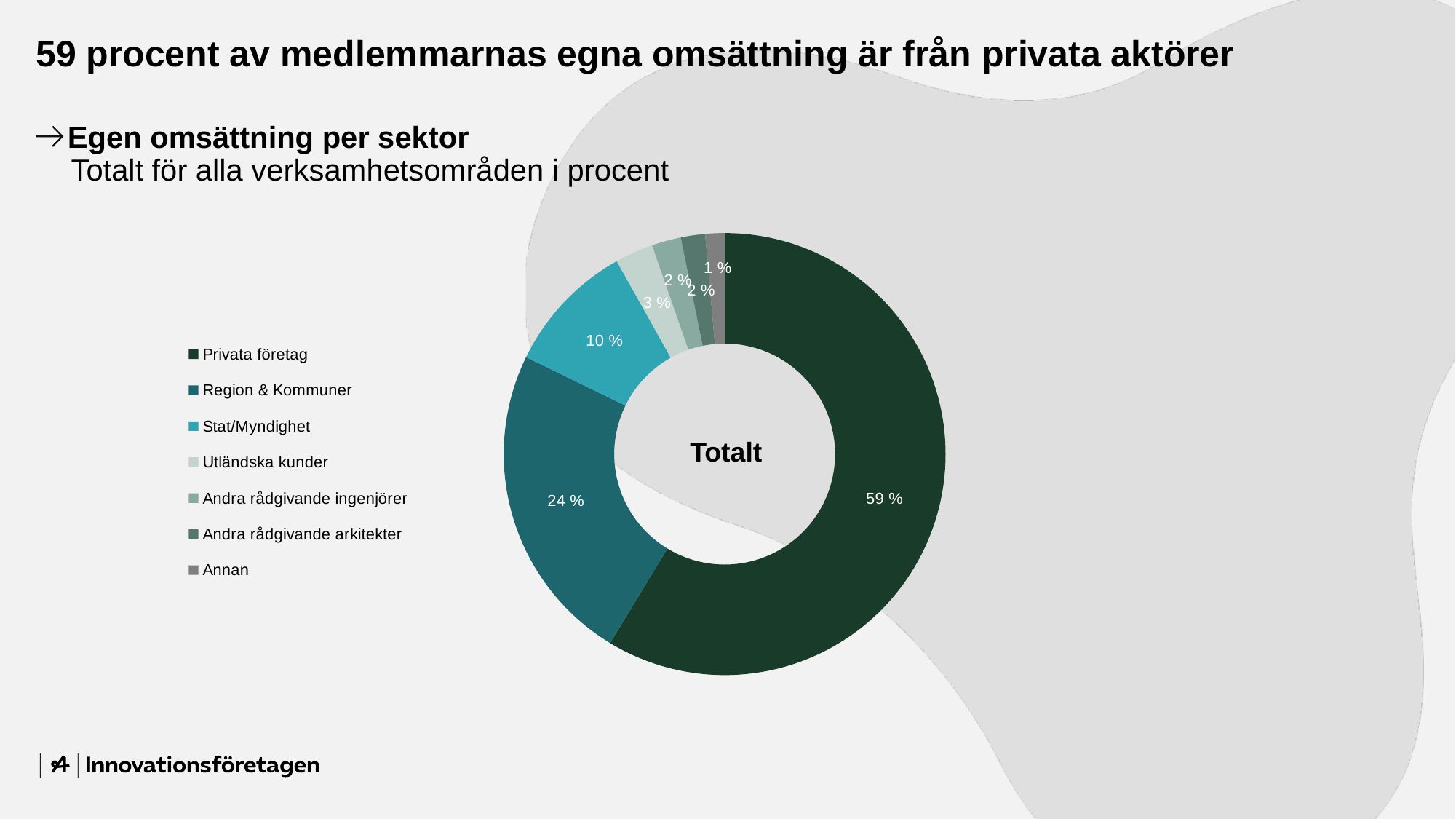
What is the value shown for Annan? 1 % Which category has the smallest share of the doughnut chart? Annan How many categories does the legend of the chart list? 7 What is the difference in percentage points between Privata företag and Region & Kommuner? 35 percentage points Which is larger, the share for Stat/Myndighet or the share for Utländska kunder? Stat/Myndighet What is the value shown for Region & Kommuner? 24 % What text is shown in the centre of the doughnut chart? Totalt Which category has the largest share of the doughnut chart? Privata företag What share of the doughnut chart does Privata företag account for? 59 % What kind of chart is shown on the slide? Doughnut (pie) chart What is the value shown for Stat/Myndighet? 10 % What is the value shown for Utländska kunder? 3 %